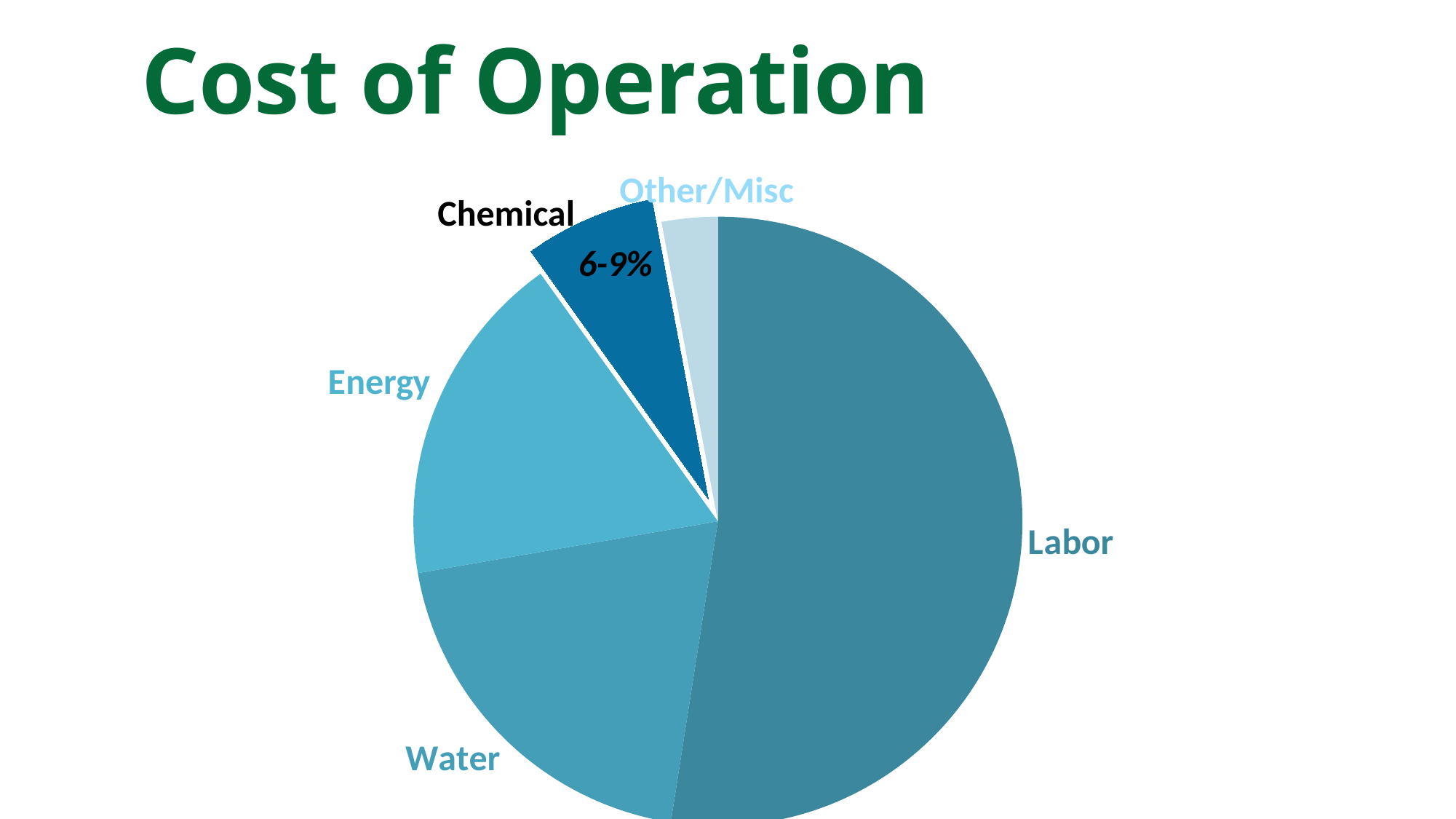
Which slice is larger, Labor or Water? Labor How many slices does the pie chart have? 5 What kind of chart is shown on the slide? pie chart Which category has the smallest slice of the pie? Other/Misc Which slice is pulled out (exploded) from the rest of the pie? Chemical Which slice is larger, Chemical or Other/Misc? Chemical What is the title of the chart? Cost of Operation What value is labelled on the Chemical slice? 6-9% Which category has the largest slice of the pie? Labor Which slice is larger, Energy or Chemical? Energy